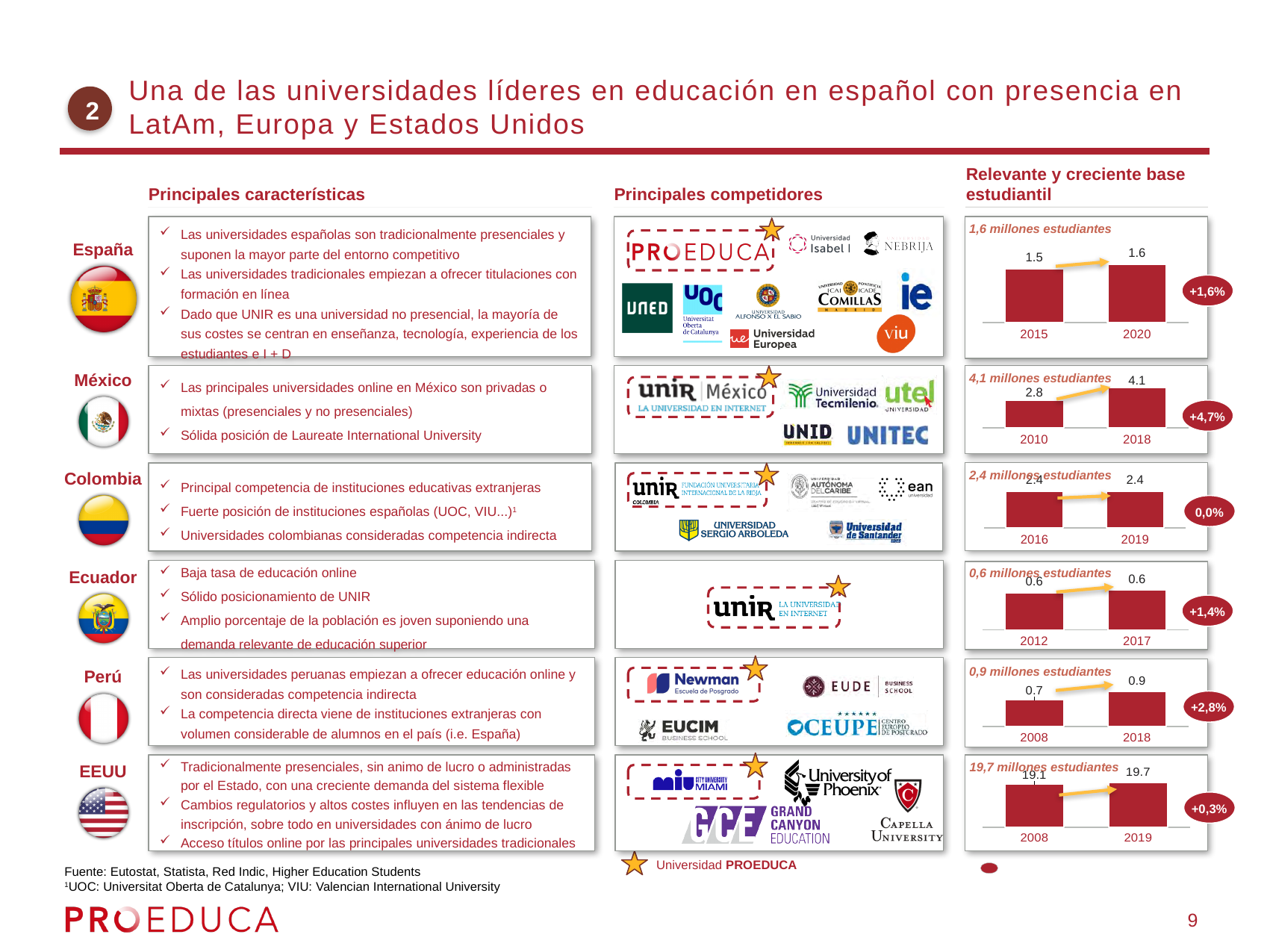
In the Ecuador chart, how many bars are plotted? 2 In the Perú chart, what is the value for 2008? 0.7 In the México chart, do the values rise or fall from 2010 to 2018? Rise In the EEUU chart, what is the difference between the 2019 and 2008 values? 0.6 What type of chart is used for the España student base? Bar chart In the EEUU chart (bottom right), what is the value for 2019? 19.7 In the Colombia chart, which year has the higher value, 2016 or 2019? They are equal (2.4) In the Perú chart, which year has the higher value, 2008 or 2018? 2018 In the México chart, what is the difference between the 2018 and 2010 values? 1.3 In the España chart (top right), what is the value for 2020? 1.6 What growth percentage is shown in the red oval next to the México chart? +4,7% In the México chart, what is the value for 2010? 2.8